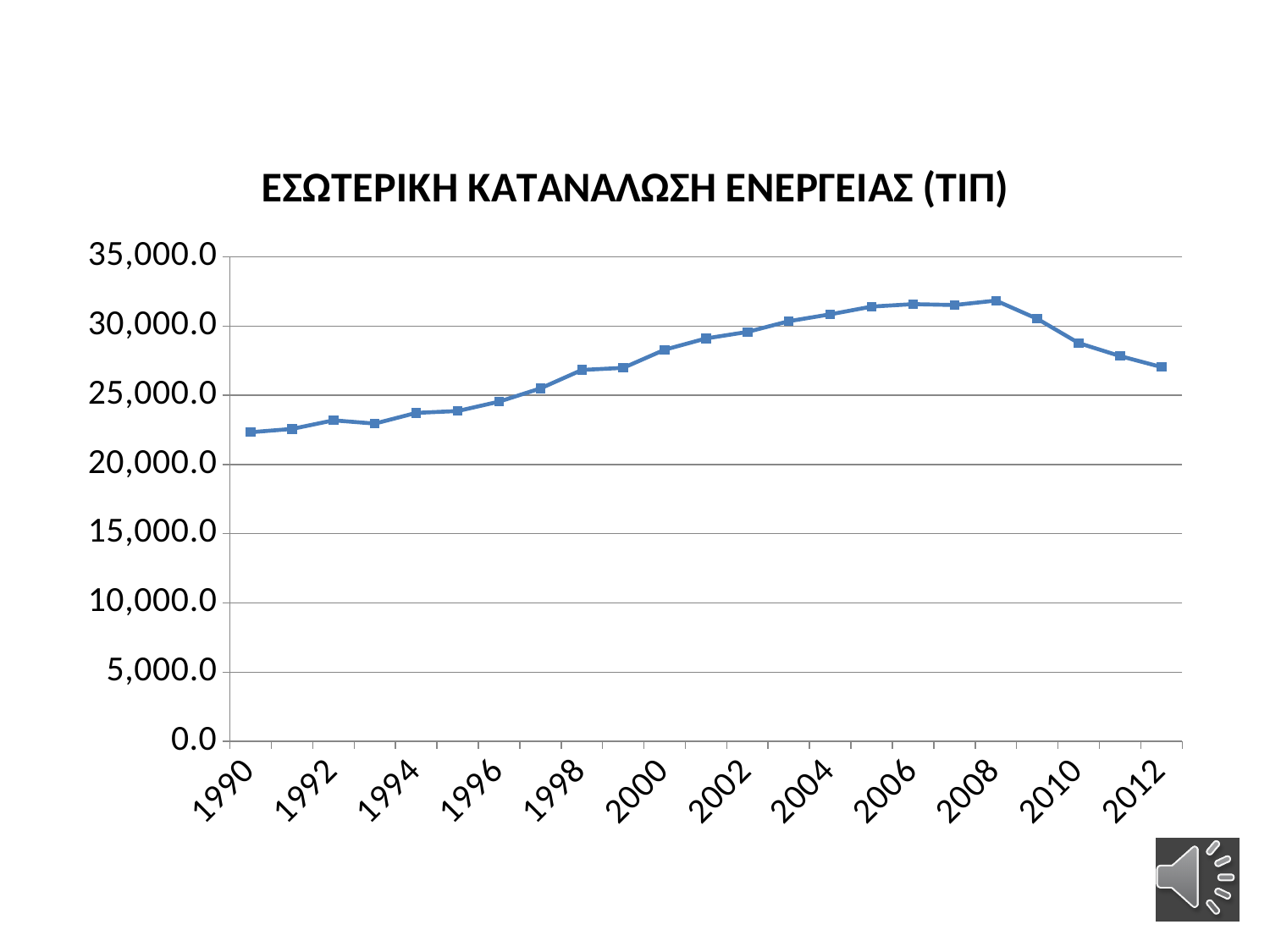
Is the value for 1990 greater or less than 25,000.0? less Do the values rise or fall from 1990 to 2008? rise Which year has the larger value, 1990 or 2008? 2008 Is the value for 2008 greater or less than 30,000.0? greater Do the values rise or fall from 2008 to 2012? fall Is the value for 2012 greater or less than 25,000.0? greater What is the title of the chart? ΕΣΩΤΕΡΙΚΗ ΚΑΤΑΝΑΛΩΣΗ ΕΝΕΡΓΕΙΑΣ (ΤΙΠ) How many data points are plotted on the line (one per year from 1990 to 2012)? 23 Which year has the larger value, 2006 or 2010? 2006 What kind of chart is shown on the slide? line chart